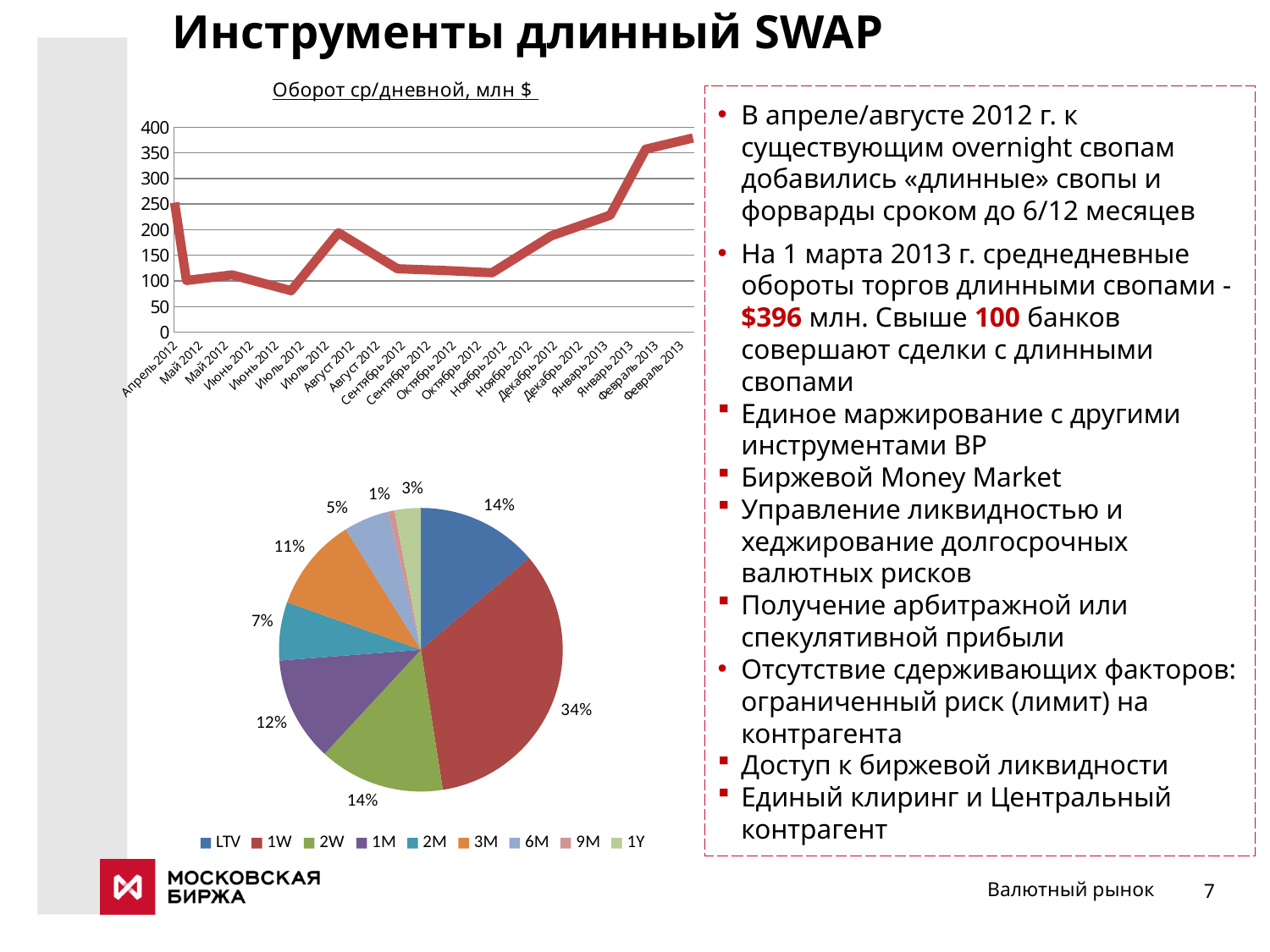
In the pie chart, which category has the largest slice? 1W In the pie chart, what share does the 1W slice have? 34% In the pie chart, which category has the smallest slice? 9M In the pie chart, what share does the 6M slice have? 5% In the pie chart, what is the difference between the 1W share and the LTV share? 20% In the pie chart, which is larger, the 2M slice or the 1M slice? 1M In the pie chart, what share does the 3M slice have? 11% In the chart titled 'Оборот ср/дневной, млн $', which month has the highest value? Февраль 2013 How many entries does the legend of the pie chart list? 9 In the chart titled 'Оборот ср/дневной, млн $', is the value for Февраль 2013 (the last point) greater or less than 350? greater In the chart titled 'Оборот ср/дневной, млн $', is the value for Апрель 2012 greater or less than 200? greater What kind of chart is the chart titled 'Оборот ср/дневной, млн $'? line chart